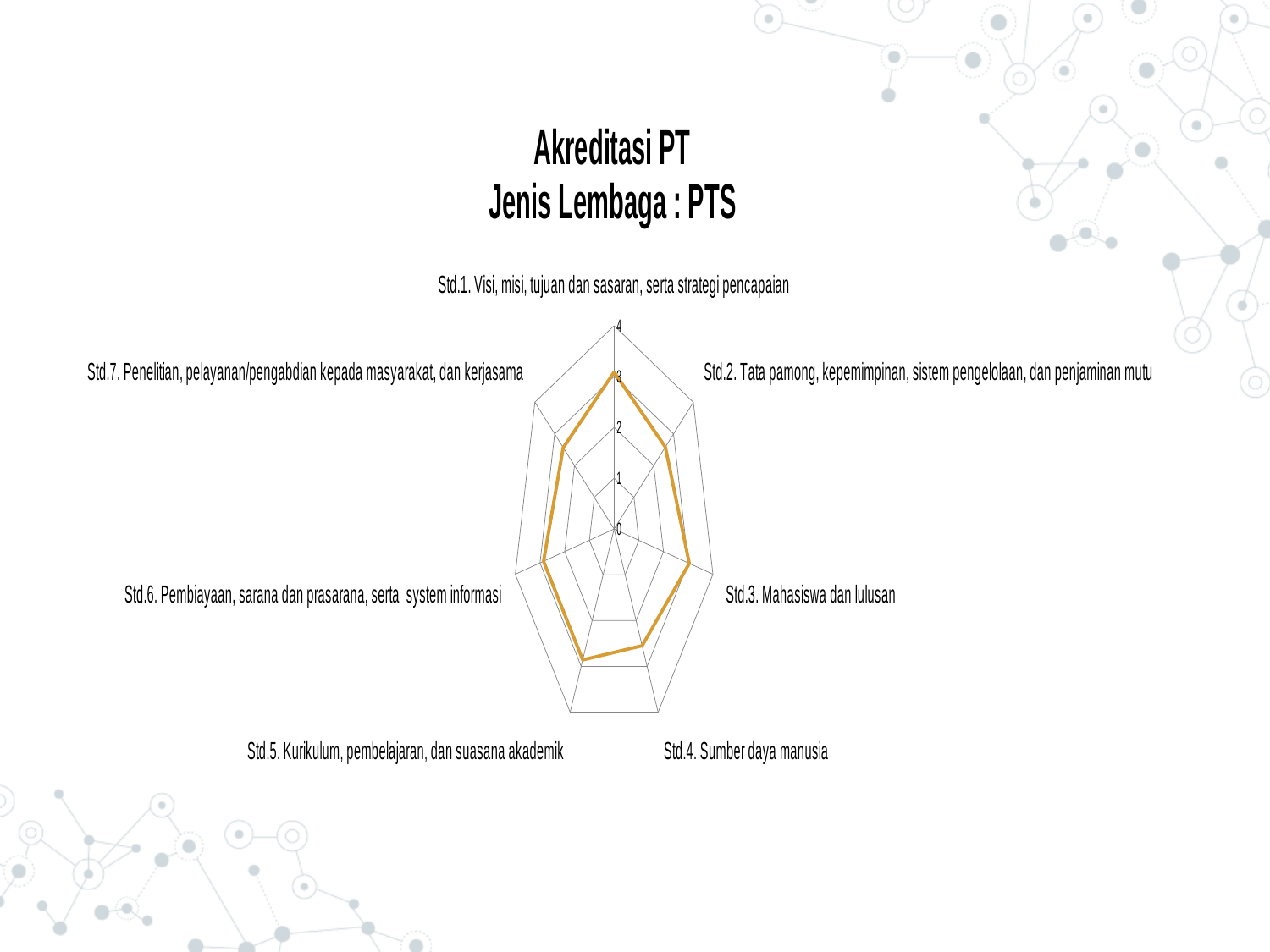
What is the title of the chart? Akreditasi PT Jenis Lembaga : PTS Is the value for Std.3 (Mahasiswa dan lulusan) greater or less than 2? greater Is the value for Std.2 (Tata pamong, kepemimpinan, sistem pengelolaan, dan penjaminan mutu) greater or less than 1? greater Is the value for Std.7 (Penelitian, pelayanan/pengabdian kepada masyarakat, dan kerjasama) greater or less than 4? less How many categories (standards) are plotted on the radar chart? 7 What kind of chart is shown on the slide? Radar chart What is the highest value shown on the chart's axis scale? 4